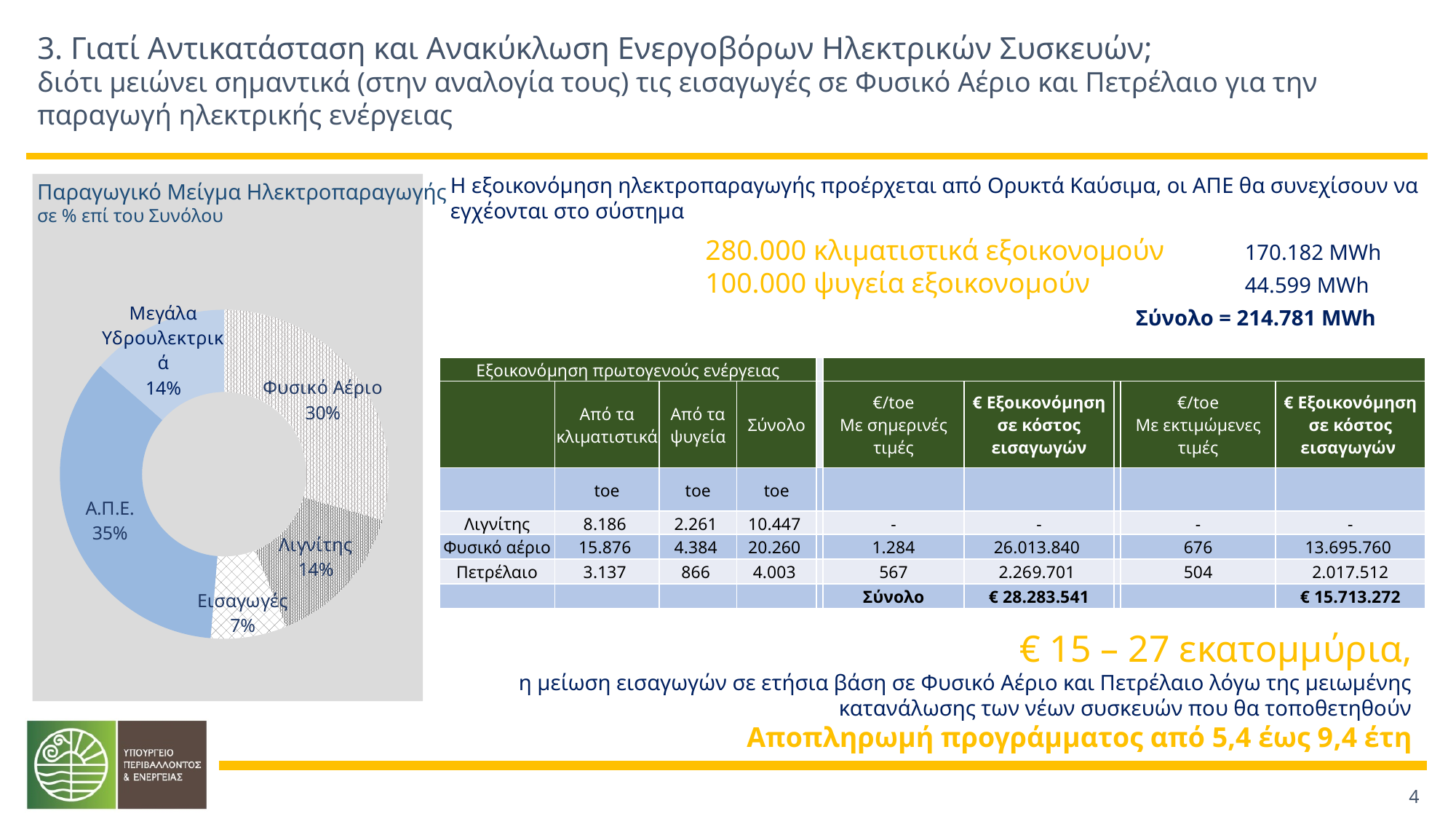
Which is larger in the pie chart, Λιγνίτης or Εισαγωγές? Λιγνίτης Which category has the smallest share in the pie chart? Εισαγωγές What is the difference in percentage points between Α.Π.Ε. and Φυσικό Αέριο? 5% What kind of chart is shown on the slide? Pie chart (doughnut) What is the combined share of Λιγνίτης and Μεγάλα Υδροηλεκτρικά? 28% What is the share of Φυσικό Αέριο in the pie chart? 30% What is the share of Α.Π.Ε. in the pie chart? 35% What is the share of Μεγάλα Υδροηλεκτρικά in the pie chart? 14% How many categories does the pie chart show? 5 What is the share of Εισαγωγές in the pie chart? 7% Which category has the largest share in the pie chart? Α.Π.Ε. What is the title of the pie chart? Παραγωγικό Μείγμα Ηλεκτροπαραγωγής σε % επί του Συνόλου